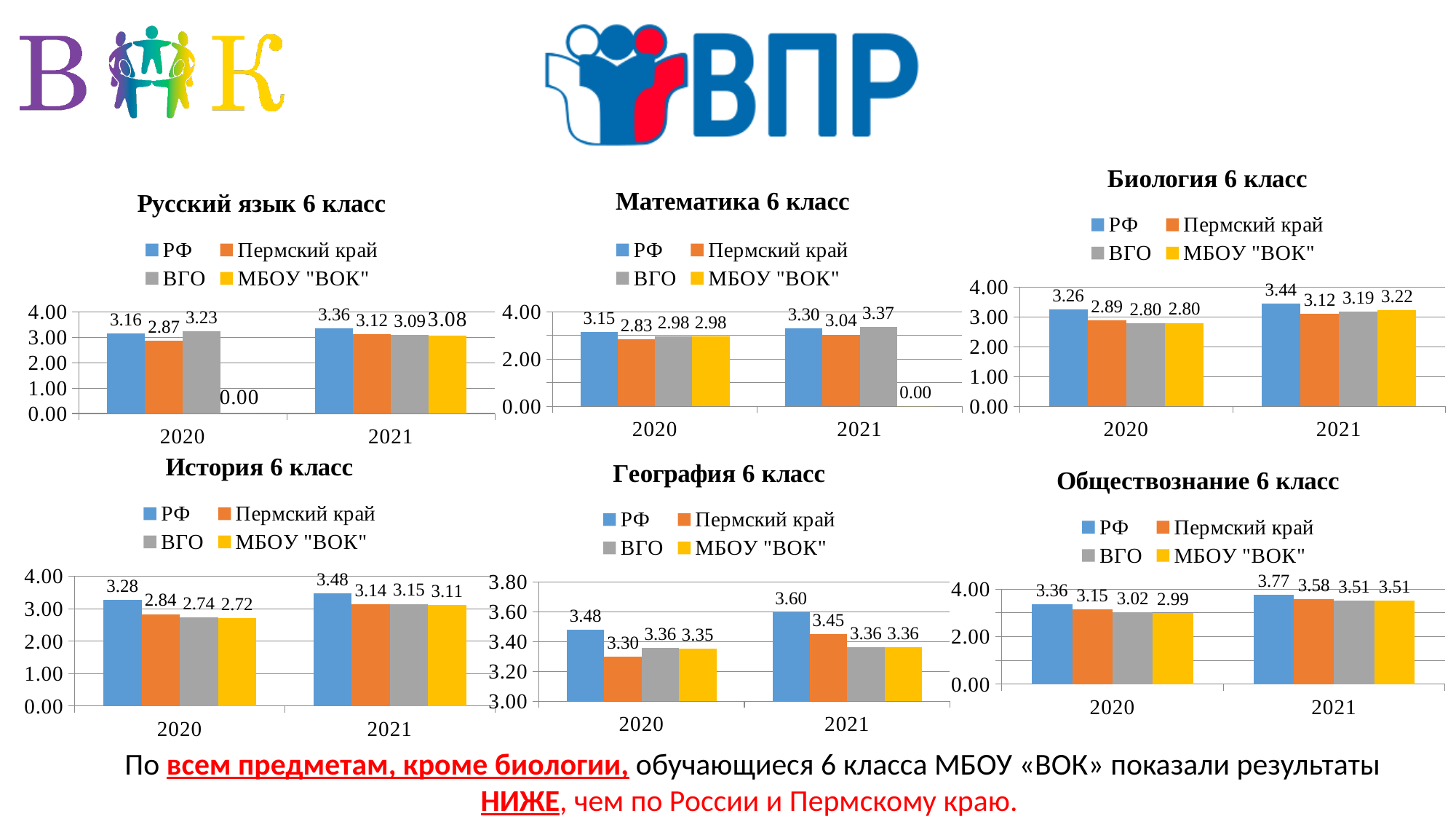
In the "География 6 класс" chart, which series has the lowest value in 2020? Пермский край In the "Обществознание 6 класс" chart, what is the difference between the РФ value and the МБОУ "ВОК" value in 2021? 0.26 In the "Биология 6 класс" chart, which is larger in 2021: the value for ВГО or the value for МБОУ "ВОК"? МБОУ "ВОК" How many year categories are shown on the x axis of the "Обществознание 6 класс" chart? 2 In the "История 6 класс" chart, which series has the highest value in 2020? РФ How many series does the legend of the "Математика 6 класс" chart list? 4 In the "Биология 6 класс" chart, what is the value for МБОУ "ВОК" in 2021? 3.22 In the "История 6 класс" chart, does the value for РФ rise or fall from 2020 to 2021? rise In the "Математика 6 класс" chart, what is the value for ВГО in 2021? 3.37 What kind of chart is the "География 6 класс" chart? bar chart In the "Русский язык 6 класс" chart, what is the value for РФ in 2021? 3.36 In the "Русский язык 6 класс" chart, what is the value for МБОУ "ВОК" in 2020? 0.00